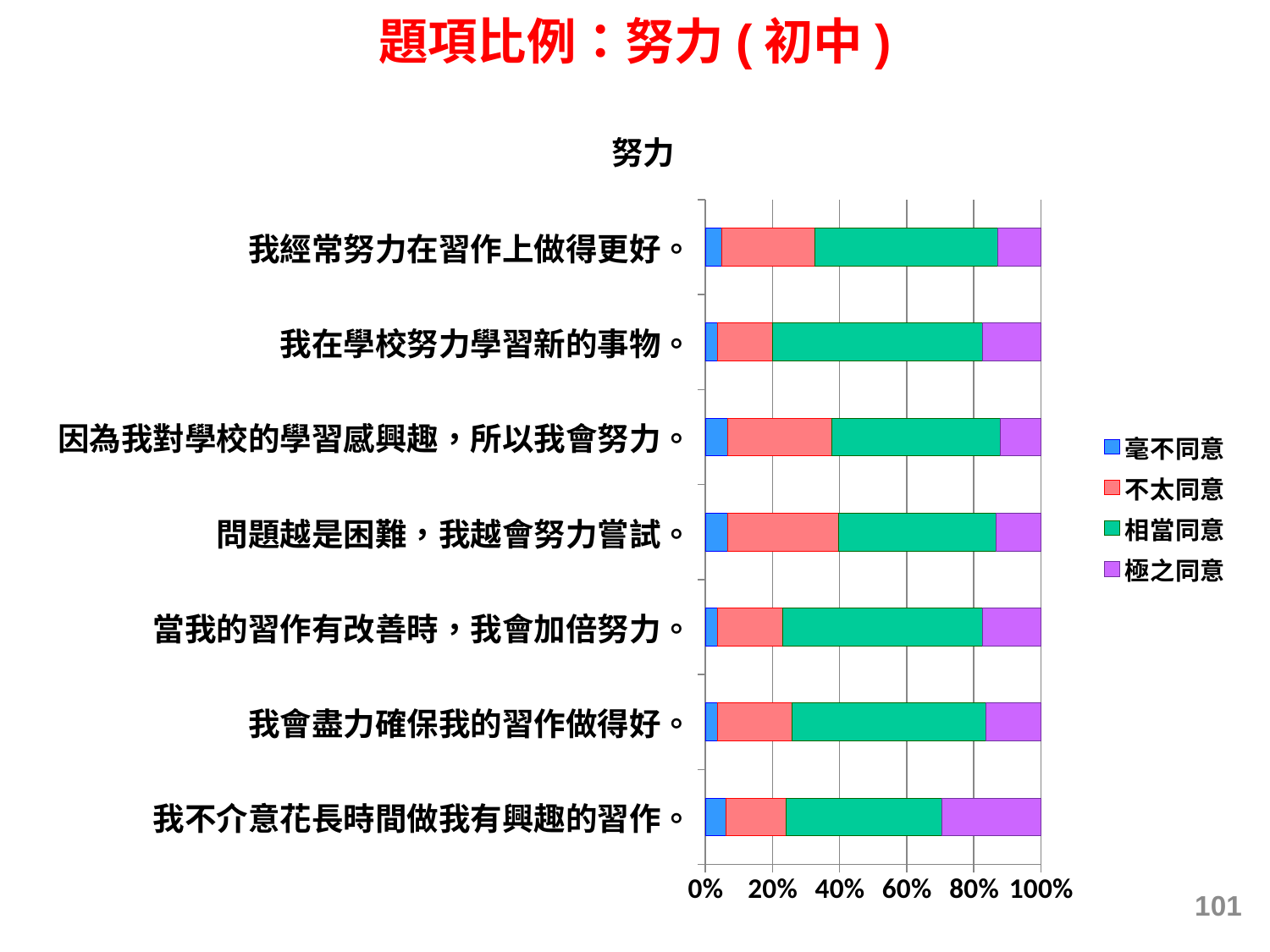
What does each full stacked bar total on the x axis? 100% Which statement has the largest 極之同意 share? 我不介意花長時間做我有興趣的習作。 Which legend entry is shown in purple? 極之同意 What kind of chart is shown on the slide? Stacked bar chart What is the title shown above the chart? 努力 Is the 極之同意 share for 我不介意花長時間做我有興趣的習作。 greater or less than 20%? greater Which has the larger 不太同意 share: 問題越是困難，我越會努力嘗試。 or 我在學校努力學習新的事物。? 問題越是困難，我越會努力嘗試。 How many statements (categories) are plotted in the chart? 7 Which has the larger 極之同意 share: 我不介意花長時間做我有興趣的習作。 or 我經常努力在習作上做得更好。? 我不介意花長時間做我有興趣的習作。 Is the 極之同意 share for 我經常努力在習作上做得更好。 greater or less than 20%? less Is the 不太同意 share for 問題越是困難，我越會努力嘗試。 greater or less than 20%? greater How many series does the legend list? 4